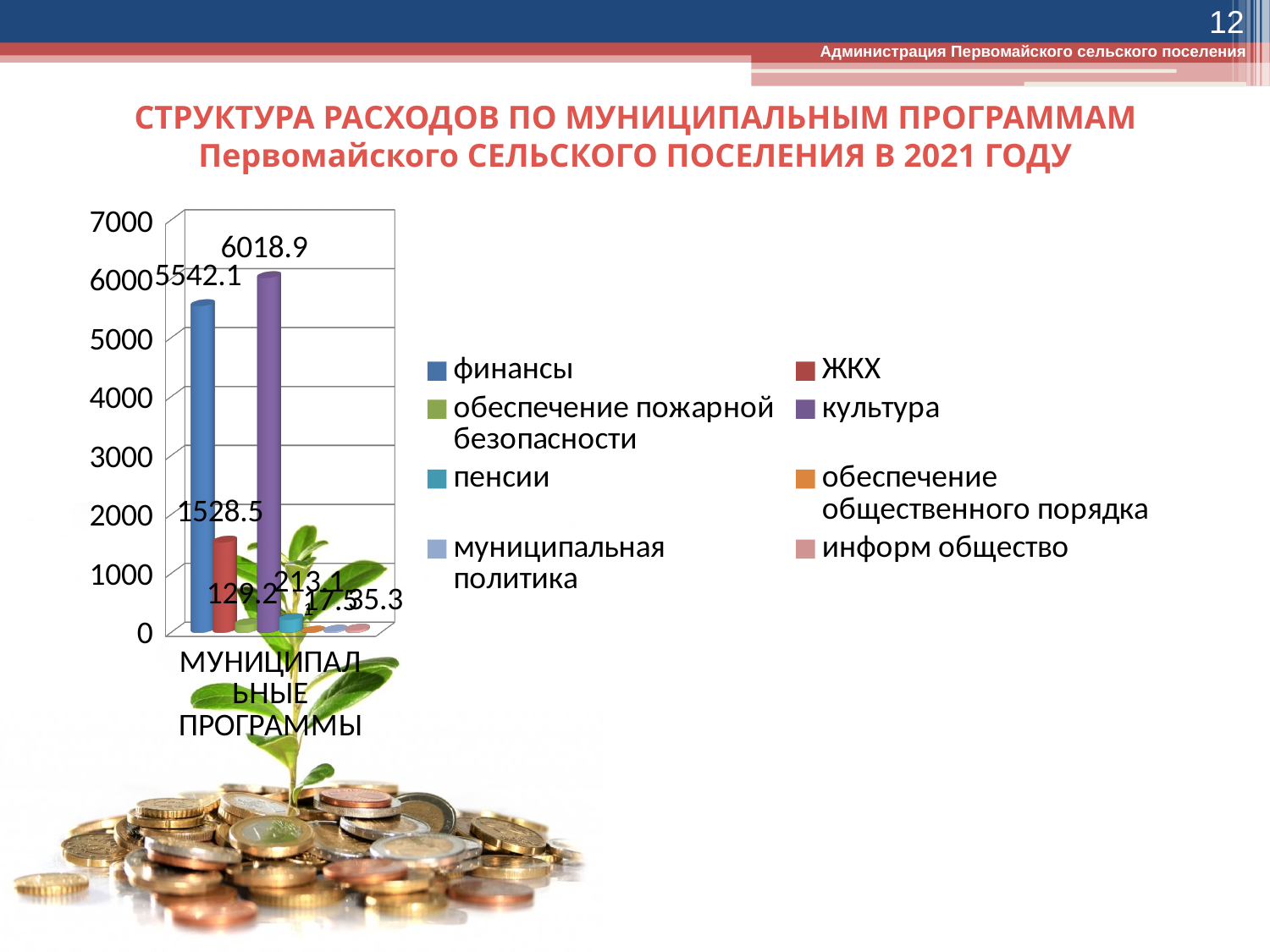
What kind of chart is shown on the slide? bar chart What is the value for культура? 6018.9 Which is larger, the value for финансы or the value for ЖКХ? финансы Which series has the highest value? культура What is the category label on the x axis of the chart? МУНИЦИПАЛЬНЫЕ ПРОГРАММЫ Is the value for культура greater or less than 6000? greater What is the difference between the values for культура and финансы? 476.8 What is the value for финансы? 5542.1 What is the difference between the values for финансы and ЖКХ? 4013.6 How many series does the legend list? 8 Is the value for ЖКХ greater or less than 2000? less What is the value for ЖКХ? 1528.5